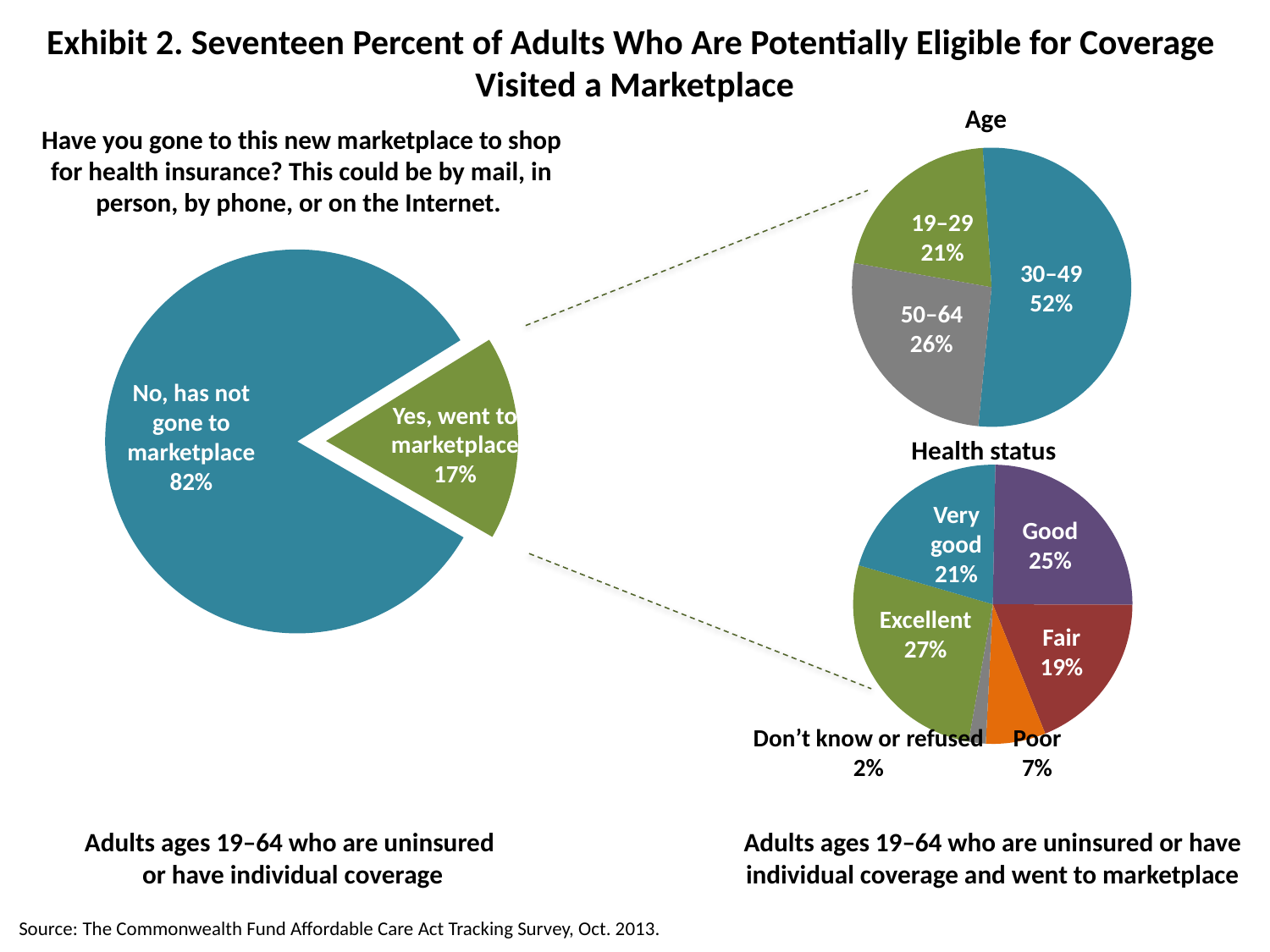
In the Health status pie chart, which category has the largest share? Excellent In the Age pie chart, what percentage of adults who went to the marketplace are ages 30–49? 52% In the Health status pie chart, what percentage reported Excellent health? 27% In the Health status pie chart, what is the difference between the Fair share and the Poor share? 12% In the Age pie chart, which age group has the smallest share? 19–29 In the Health status pie chart, which is larger, the Good share or the Fair share? Good How many categories does the Health status pie chart show? 6 In the large pie chart on the left, what percentage of adults said they had not gone to the marketplace? 82% What kind of chart is used for the Age breakdown? Pie chart In the Health status pie chart, which category has the smallest share? Don’t know or refused In the Age pie chart, what is the difference between the 50–64 share and the 19–29 share? 5% In the large pie chart on the left, what share of adults went to the marketplace? 17%